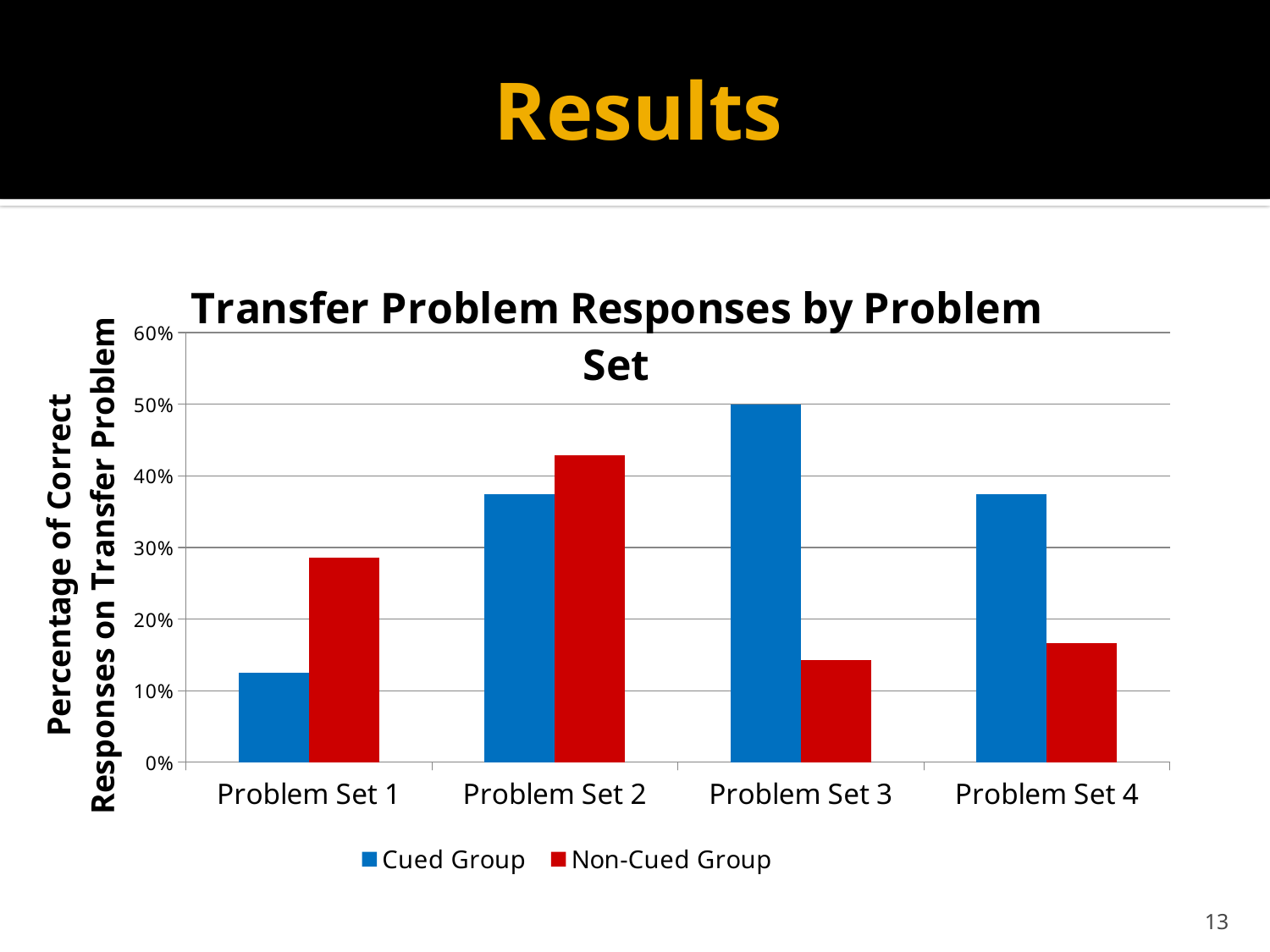
What is the value for the Cued Group on Problem Set 3? 50% What is the title of the chart? Transfer Problem Responses by Problem Set Is the value for the Cued Group on Problem Set 1 greater or less than 20%? less How many problem sets are shown on the x axis? 4 For which problem set is the Non-Cued Group value highest? Problem Set 2 On Problem Set 3, which group has the larger value, Cued Group or Non-Cued Group? Cued Group What kind of chart is shown on the slide? bar chart For which problem set is the Cued Group value highest? Problem Set 3 How many series does the legend list? 2 Is the value for the Non-Cued Group on Problem Set 2 greater or less than 40%? greater On Problem Set 1, which group has the larger value, Cued Group or Non-Cued Group? Non-Cued Group For which problem set is the Cued Group value lowest? Problem Set 1